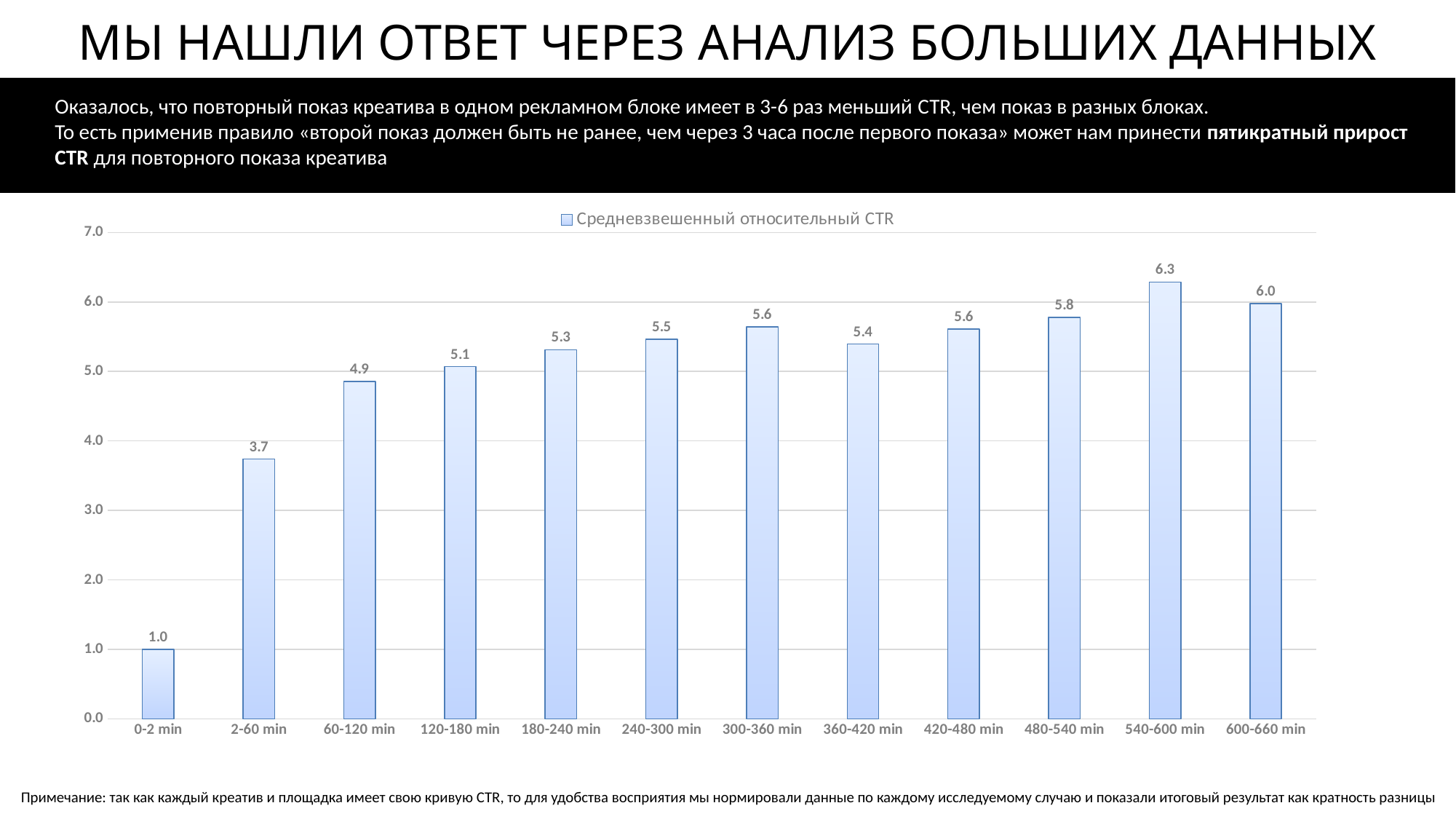
What is the value for the 120-180 min category? 5.1 What is the difference between the values for 540-600 min and 0-2 min? 5.3 What is the series name shown in the legend? Средневзвешенный относительный CTR Which category has the highest value? 540-600 min Is the value for 360-420 min greater or less than 5.0? greater What kind of chart is shown on the slide? bar chart How many series does the legend list? 1 Which category has the lowest value? 0-2 min What is the value for the 600-660 min category? 6.0 What is the value for the 0-2 min category? 1.0 How many categories are shown on the x axis? 12 Which is larger, the value for 2-60 min or the value for 60-120 min? 60-120 min